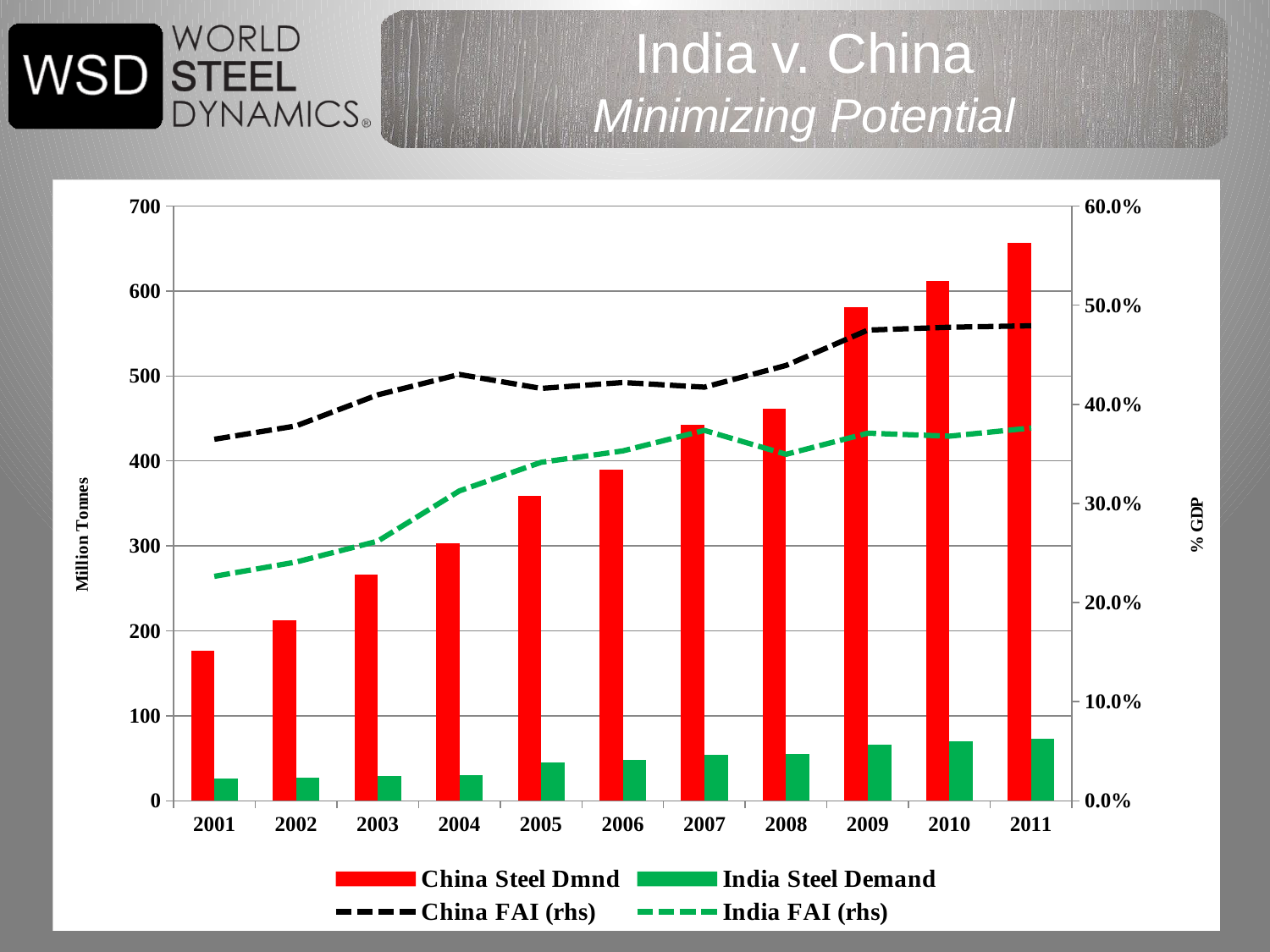
How many years are shown on the x axis? 11 Does China Steel Dmnd rise or fall from 2001 to 2011? rise How many series does the legend list? 4 In which year is China Steel Dmnd lowest? 2001 Is the value for India FAI (rhs) in 2001 greater or less than 30.0%? less Is the value for China FAI (rhs) in 2011 greater or less than 40.0%? greater In which year is China Steel Dmnd highest? 2011 Is the value for China Steel Dmnd in 2008 greater or less than 500? less What is the label of the left vertical axis? Million Tonnes In 2005, which is larger: China FAI (rhs) or India FAI (rhs)? China FAI (rhs) What kind of chart is shown on the slide? bar and line chart